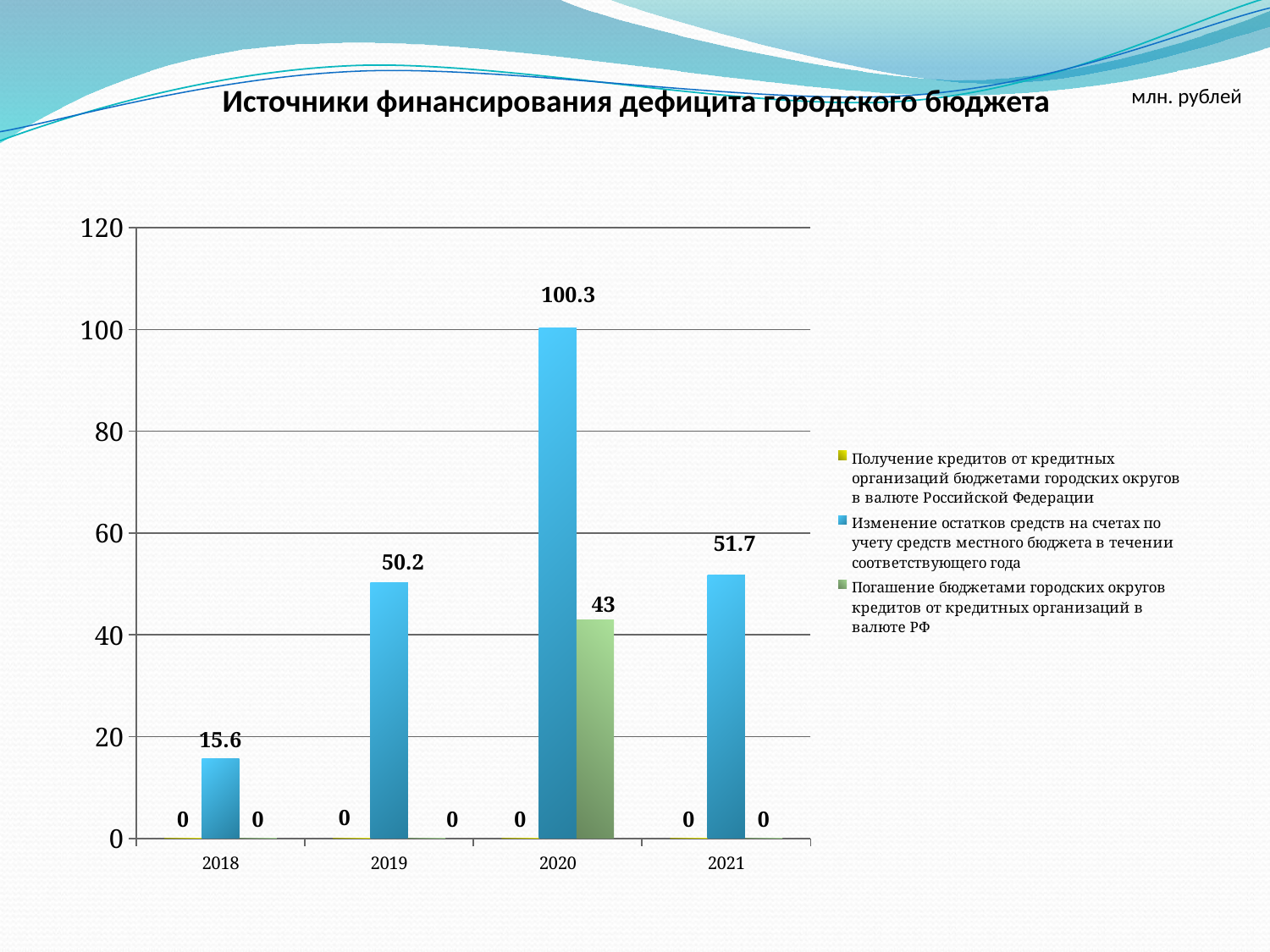
What is the value for 'Погашение бюджетами городских округов кредитов от кредитных организаций в валюте РФ' in 2020? 43 Which is larger: the 2019 or the 2021 value for 'Изменение остатков средств на счетах по учету средств местного бюджета в течении соответствующего года'? 2021 What is the difference between the 2020 and 2021 values for 'Изменение остатков средств на счетах по учету средств местного бюджета в течении соответствующего года'? 48.6 What is the value for 'Получение кредитов от кредитных организаций бюджетами городских округов в валюте Российской Федерации' in 2019? 0 How many series does the legend list? 3 What is the value for 'Изменение остатков средств на счетах по учету средств местного бюджета в течении соответствующего года' in 2020? 100.3 In which year is the value for 'Изменение остатков средств на счетах по учету средств местного бюджета в течении соответствующего года' the lowest? 2018 In which year is the value for 'Изменение остатков средств на счетах по учету средств местного бюджета в течении соответствующего года' the highest? 2020 What is the value for 'Изменение остатков средств на счетах по учету средств местного бюджета в течении соответствующего года' in 2018? 15.6 How many years are shown on the x axis? 4 What type of chart is shown on the slide? bar chart What unit is stated for the values on the chart? млн. рублей